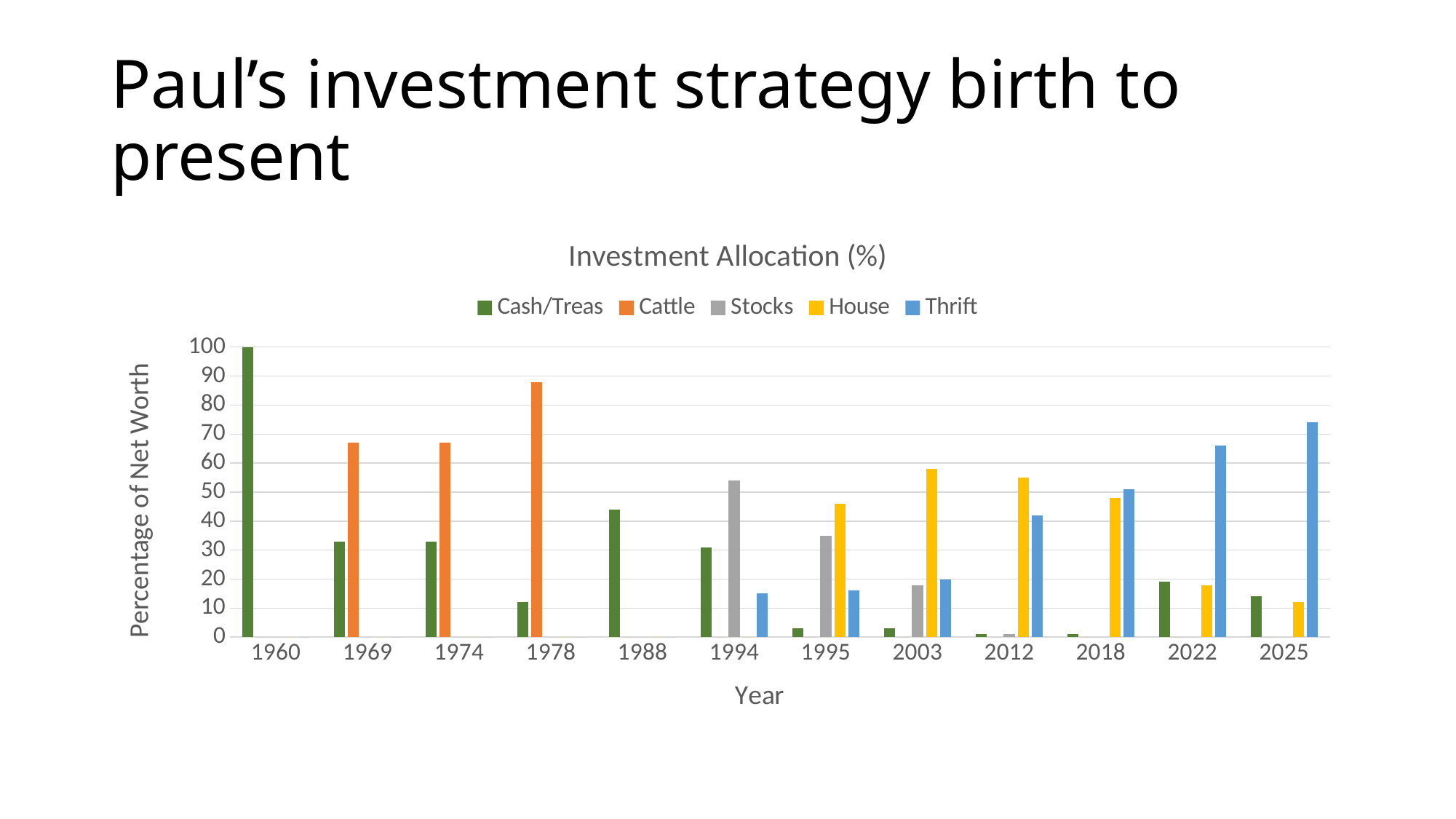
What kind of chart is shown on the slide? bar chart Is the Stocks value for 1994 greater or less than 50? greater What is the title of the chart? Investment Allocation (%) Does the Cash/Treas value rise or fall from 1960 to 1978? fall How many years are shown on the x axis? 12 In which year is the Thrift value highest? 2025 In 1969, which is larger, Cash/Treas or Cattle? Cattle Is the Thrift value for 2025 greater or less than 70? greater Is the Cattle value for 1978 greater or less than 80? greater How many series does the legend list? 5 Which series has the highest value in 2003? House What is the Cash/Treas value for 1960? 100